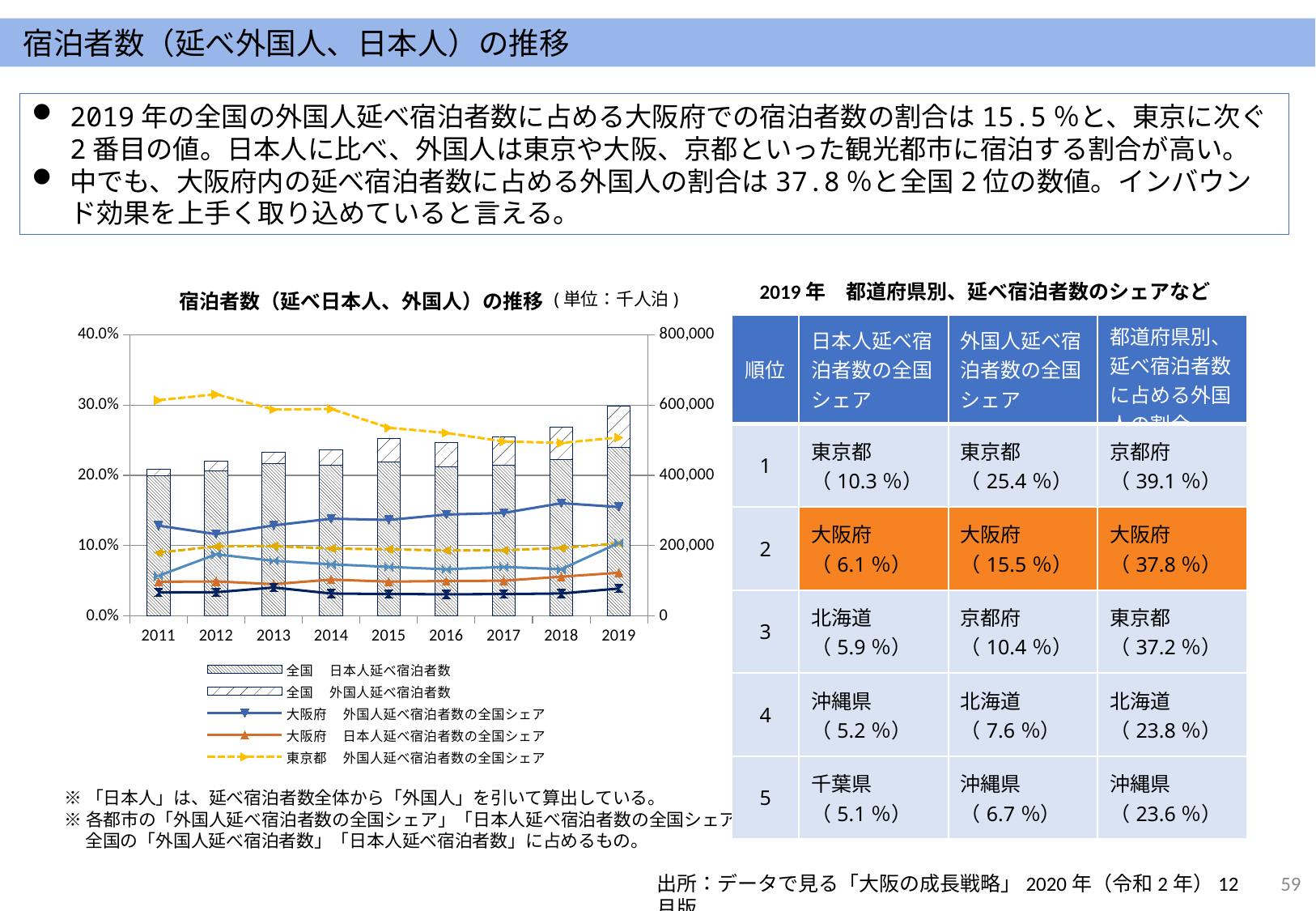
In the chart 「宿泊者数（延べ日本人、外国人）の推移」, which is larger in 2019: the 東京都 外国人延べ宿泊者数の全国シェア or the 大阪府 外国人延べ宿泊者数の全国シェア? 東京都 外国人延べ宿泊者数の全国シェア In the chart 「宿泊者数（延べ日本人、外国人）の推移」, which year has the shortest stacked bar? 2011 In the chart 「宿泊者数（延べ日本人、外国人）の推移」, which year has the tallest stacked bar? 2019 How many series does the legend of the chart 「宿泊者数（延べ日本人、外国人）の推移」 list? 5 What kind of chart is 「宿泊者数（延べ日本人、外国人）の推移」? A combination of stacked bar chart and line chart What unit is stated next to the title of the chart 「宿泊者数（延べ日本人、外国人）の推移」? 千人泊 In the chart 「宿泊者数（延べ日本人、外国人）の推移」, is the 東京都 外国人延べ宿泊者数の全国シェア value for 2019 greater or less than 30.0%? less In the chart 「宿泊者数（延べ日本人、外国人）の推移」, is the 東京都 外国人延べ宿泊者数の全国シェア value for 2012 greater or less than 30.0%? greater In the chart 「宿泊者数（延べ日本人、外国人）の推移」, is the 大阪府 外国人延べ宿泊者数の全国シェア value for 2019 greater or less than 10.0%? greater In the chart 「宿泊者数（延べ日本人、外国人）の推移」, does the 東京都 外国人延べ宿泊者数の全国シェア line rise or fall from 2011 to 2019? Fall How many years are shown on the x axis of the chart 「宿泊者数（延べ日本人、外国人）の推移」? 9